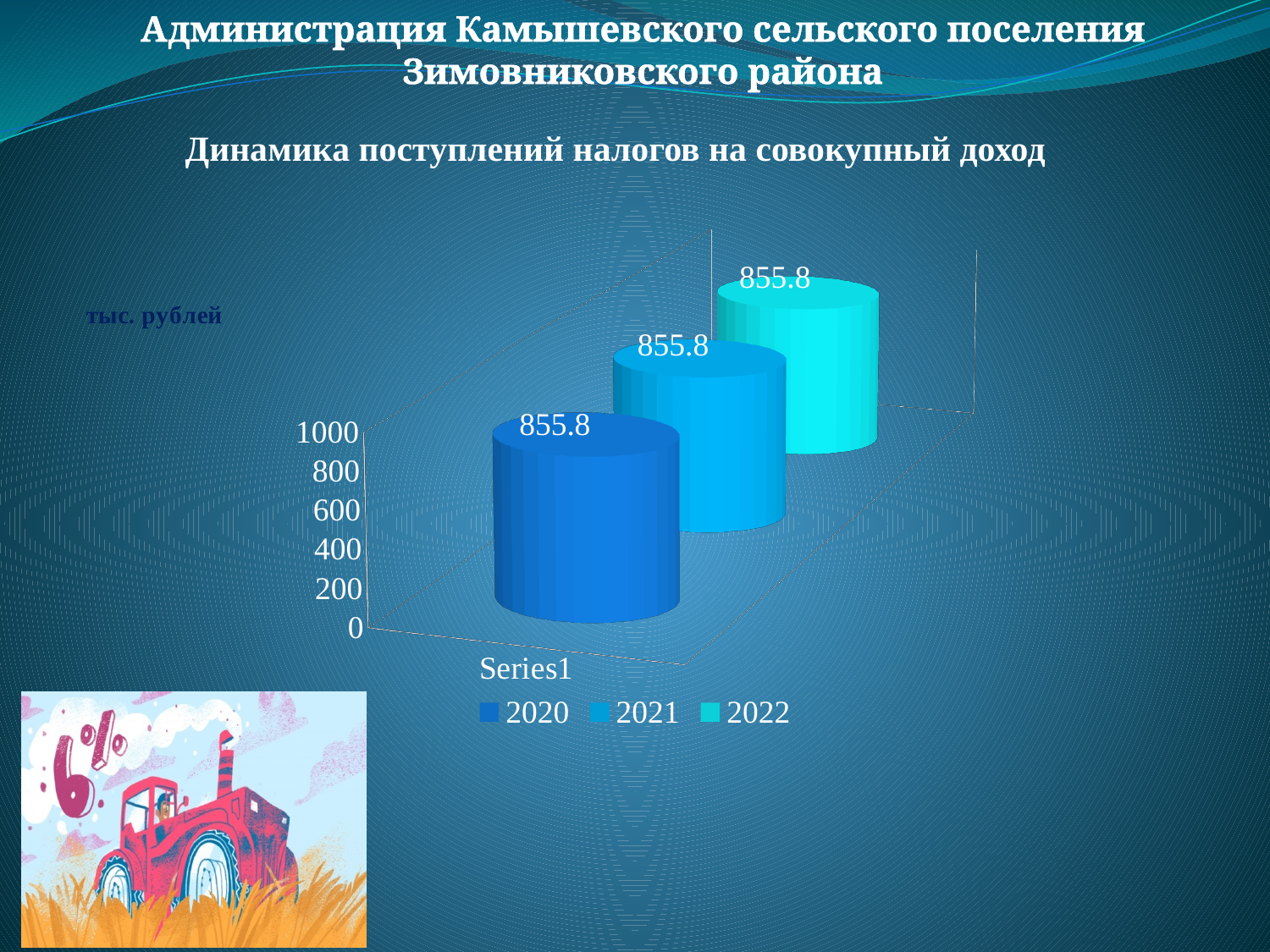
What is the value for 2020 on the chart? 855.8 Is the value for 2020 greater or less than 800? greater Do the values rise, fall, or stay the same from 2020 to 2022? stay the same What is the title of the chart? Динамика поступлений налогов на совокупный доход What is the value for 2022 on the chart? 855.8 How many categories are shown on the x axis? 1 What is the value for 2021 on the chart? 855.8 How many series does the legend list? 3 What kind of chart is shown on the slide? bar chart Is the value for 2021 greater or less than 1000? less What is the difference between the values for 2022 and 2020? 0 In what units are the chart values given, according to the label on the slide? тыс. рублей